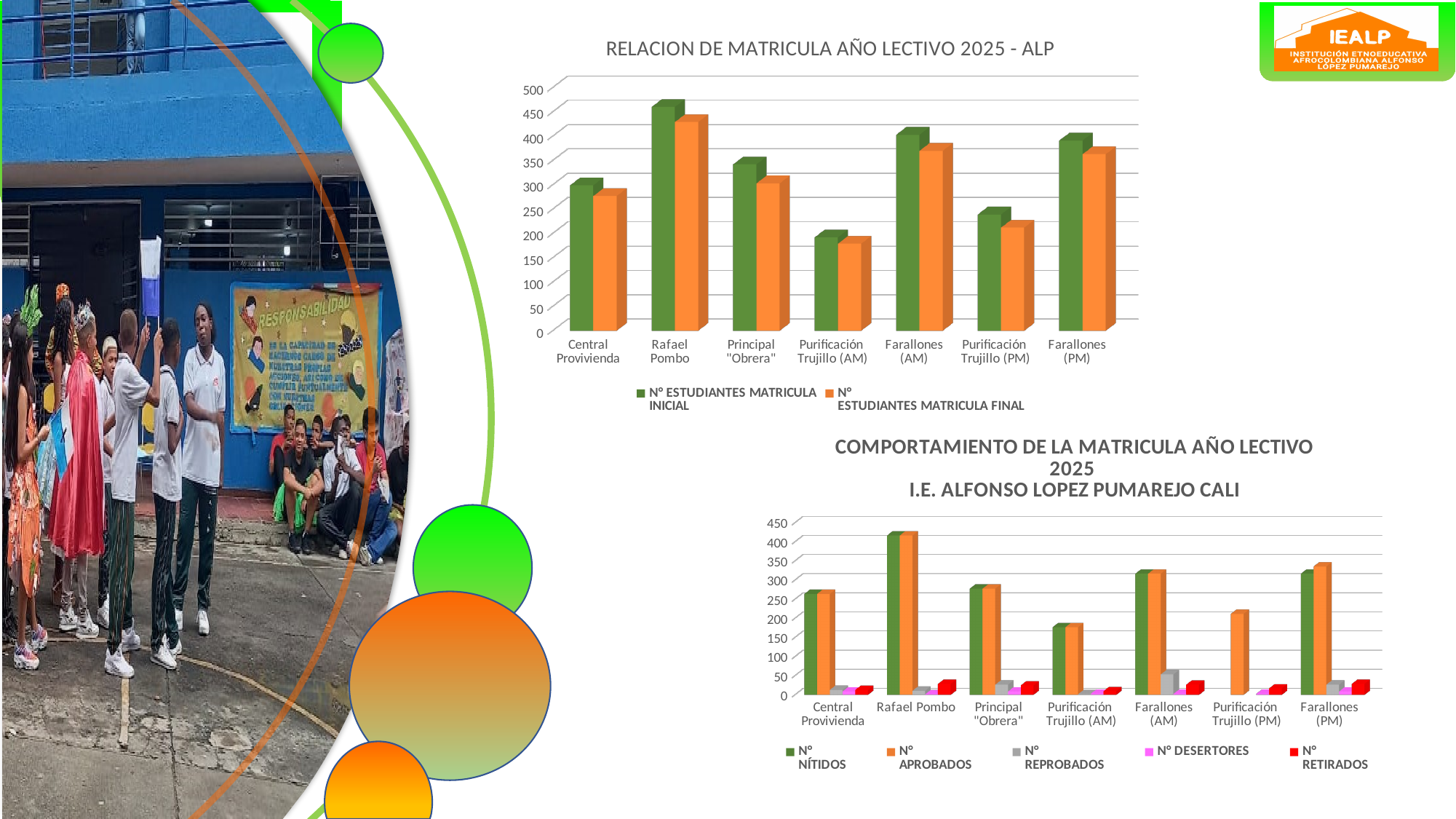
In the chart titled 'RELACION DE MATRICULA AÑO LECTIVO 2025 - ALP', is the N° ESTUDIANTES MATRICULA INICIAL for Rafael Pombo greater or less than 400? greater In the chart titled 'COMPORTAMIENTO DE LA MATRICULA AÑO LECTIVO 2025 I.E. ALFONSO LOPEZ PUMAREJO CALI', is the N° APROBADOS for Rafael Pombo greater or less than 400? greater In the chart titled 'RELACION DE MATRICULA AÑO LECTIVO 2025 - ALP', which has a larger N° ESTUDIANTES MATRICULA INICIAL: Central Provivienda or Principal "Obrera"? Principal "Obrera" In the chart titled 'RELACION DE MATRICULA AÑO LECTIVO 2025 - ALP', how many series does the legend list? 2 In the chart titled 'RELACION DE MATRICULA AÑO LECTIVO 2025 - ALP', which category has the highest N° ESTUDIANTES MATRICULA INICIAL? Rafael Pombo In the chart titled 'RELACION DE MATRICULA AÑO LECTIVO 2025 - ALP', is the N° ESTUDIANTES MATRICULA FINAL for Purificación Trujillo (AM) greater or less than 200? less In the chart titled 'RELACION DE MATRICULA AÑO LECTIVO 2025 - ALP', which category has the lowest N° ESTUDIANTES MATRICULA INICIAL? Purificación Trujillo (AM) In the chart titled 'RELACION DE MATRICULA AÑO LECTIVO 2025 - ALP', how many categories (sedes) are shown on the x axis? 7 In the chart titled 'COMPORTAMIENTO DE LA MATRICULA AÑO LECTIVO 2025 I.E. ALFONSO LOPEZ PUMAREJO CALI', which series is shown in red? N° RETIRADOS In the chart titled 'COMPORTAMIENTO DE LA MATRICULA AÑO LECTIVO 2025 I.E. ALFONSO LOPEZ PUMAREJO CALI', which category has the highest N° APROBADOS? Rafael Pombo In the chart titled 'RELACION DE MATRICULA AÑO LECTIVO 2025 - ALP', what kind of chart is shown? Bar chart In the chart titled 'COMPORTAMIENTO DE LA MATRICULA AÑO LECTIVO 2025 I.E. ALFONSO LOPEZ PUMAREJO CALI', how many series does the legend list? 5